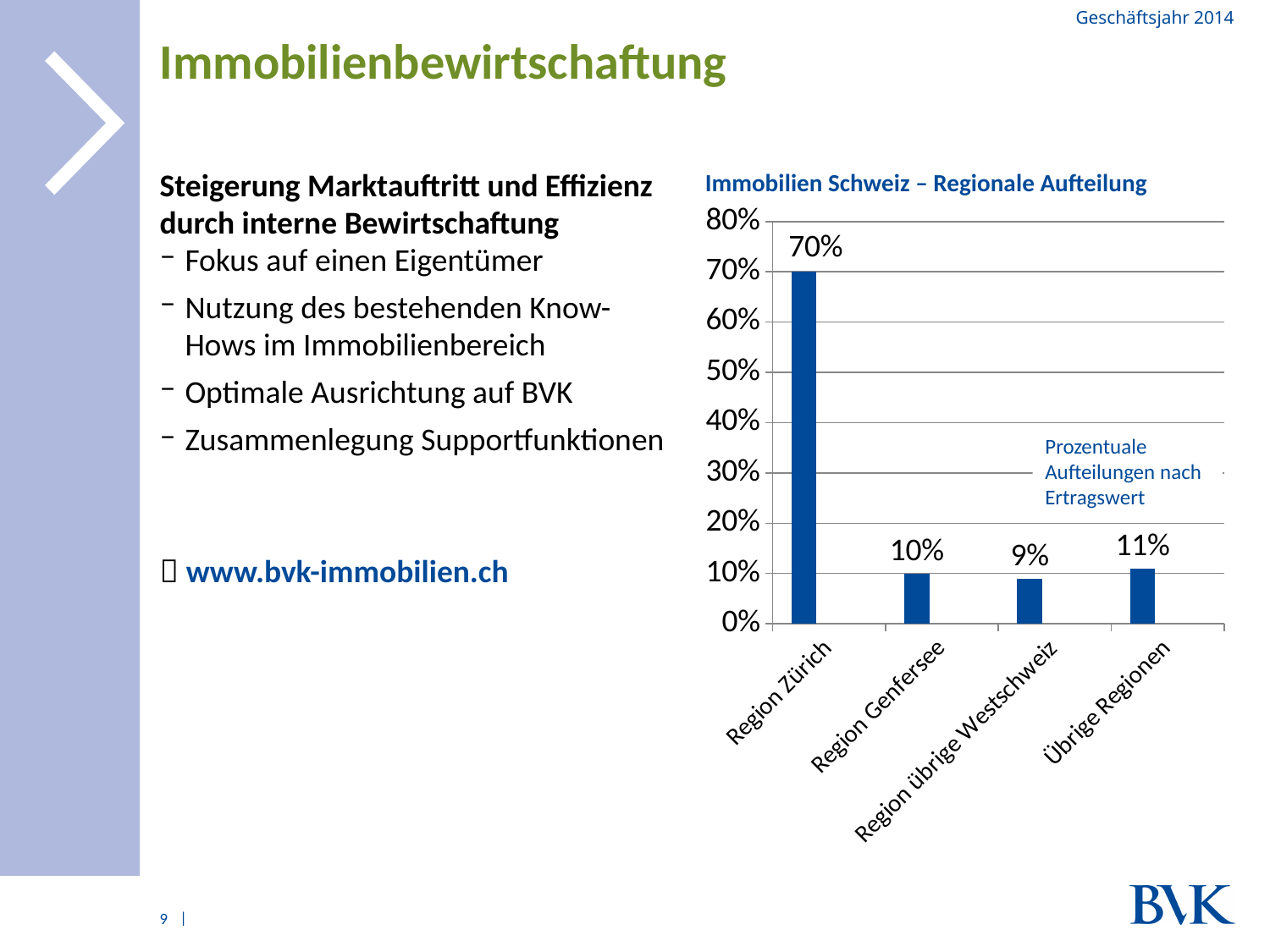
What is the value for Region Genfersee? 10% Is the value for Region Zürich greater or less than 60%? greater What is the value for Übrige Regionen? 11% Which region has the highest value? Region Zürich Which region has the lowest value? Region übrige Westschweiz What kind of chart is shown on the slide? bar chart What is the value for Region Zürich? 70% What is the value for Region übrige Westschweiz? 9% Which is larger, the value for Region Genfersee or Übrige Regionen? Übrige Regionen How many regions are shown in the chart? 4 What is the difference between the values for Region Zürich and Übrige Regionen? 59% What is the title of the chart? Immobilien Schweiz – Regionale Aufteilung